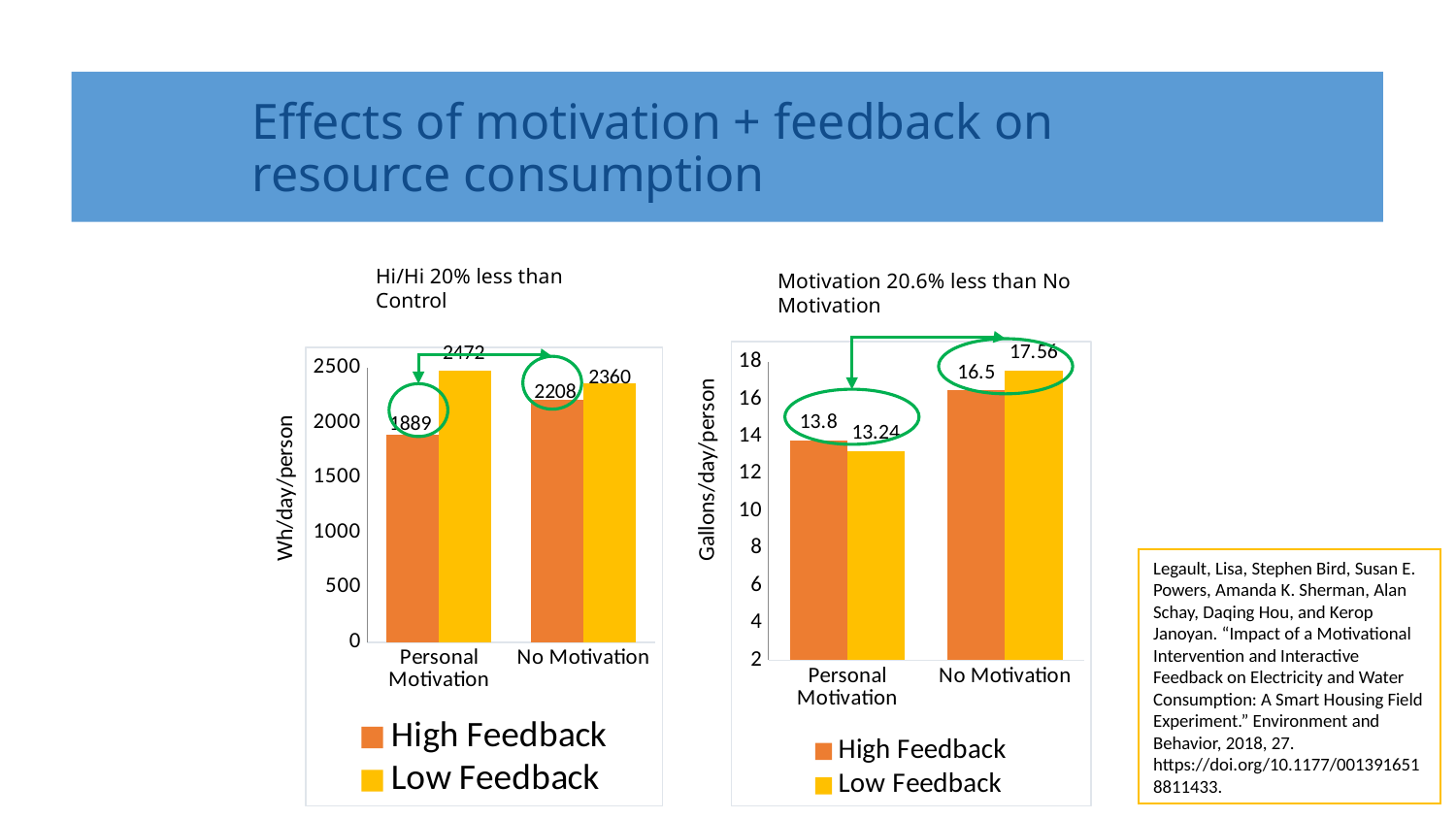
What type of chart is the right chart (Gallons/day/person)? Bar chart In the right chart (Gallons/day/person), what is the difference between the Low Feedback and High Feedback values for No Motivation? 1.06 In the right chart (Gallons/day/person), which is larger for Personal Motivation: High Feedback or Low Feedback? High Feedback In the left chart (Wh/day/person), is the High Feedback value for No Motivation greater or less than 2000? greater How many series does the legend of the left chart (Wh/day/person) list? 2 In the right chart (Gallons/day/person), what is the High Feedback value for Personal Motivation? 13.8 In the right chart (Gallons/day/person), what is the Low Feedback value for No Motivation? 17.56 In the left chart (Wh/day/person), which bar has the highest value? Low Feedback, Personal Motivation In the left chart (Wh/day/person), what is the Low Feedback value for No Motivation? 2360 In the left chart (Wh/day/person), what is the difference between the Low Feedback and High Feedback values for Personal Motivation? 583 In the left chart (Wh/day/person), what is the High Feedback value for Personal Motivation? 1889 In the right chart (Gallons/day/person), which bar has the lowest value? Low Feedback, Personal Motivation